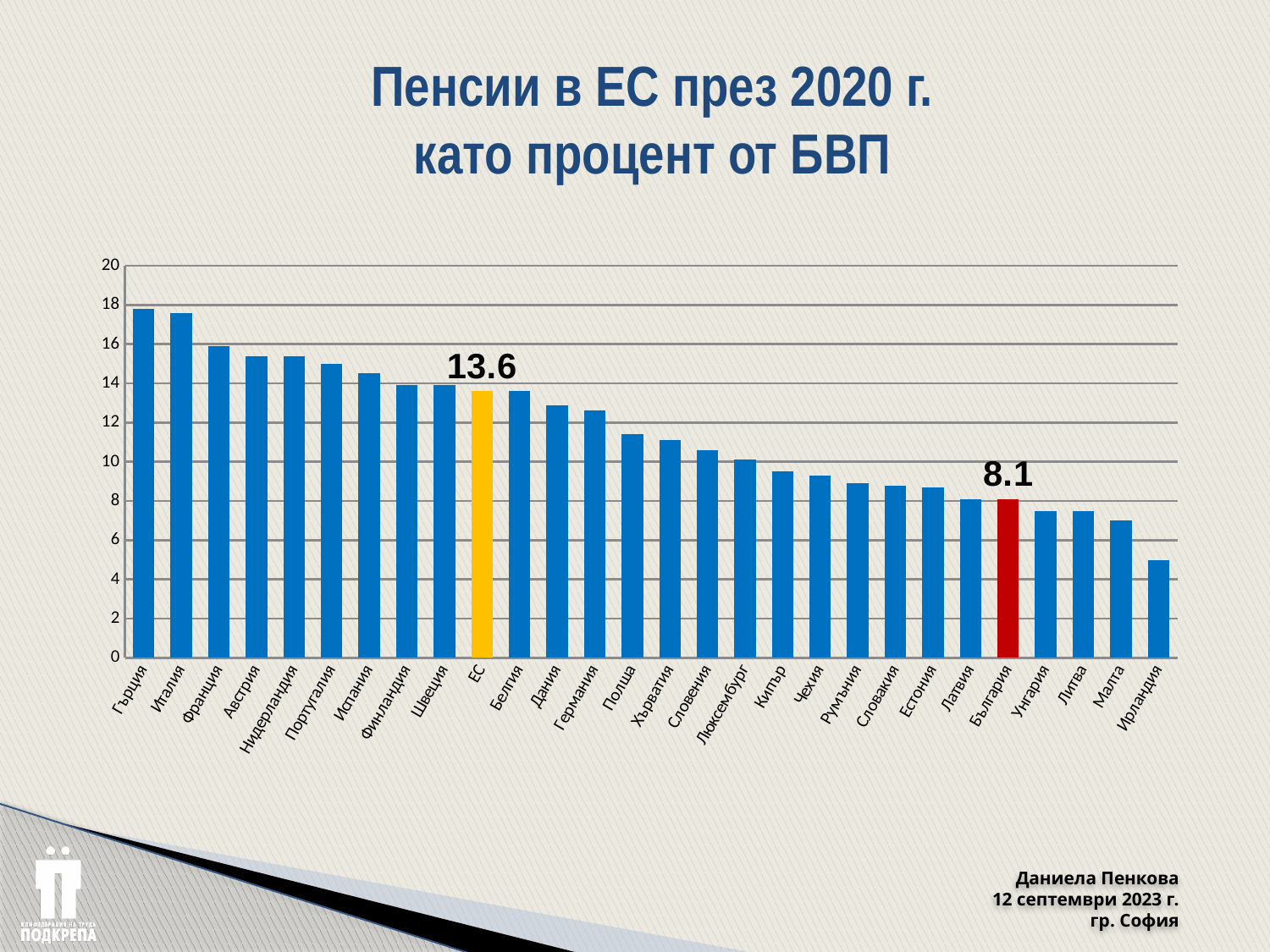
What kind of chart is shown on the slide? bar chart Is the value for Гърция greater or less than 16? greater Is the value for Ирландия greater or less than 6? less Is the value for Полша greater or less than 10? greater Which country has the lowest value? Ирландия What colour is the bar for България? red Which is larger, the value for Франция or the value for Дания? Франция What is the difference between the values for ЕС and България? 5.5 What is the value for ЕС? 13.6 Do the values rise or fall from left to right along the x axis? fall How many bars are shown in the chart? 28 What is the value for България? 8.1